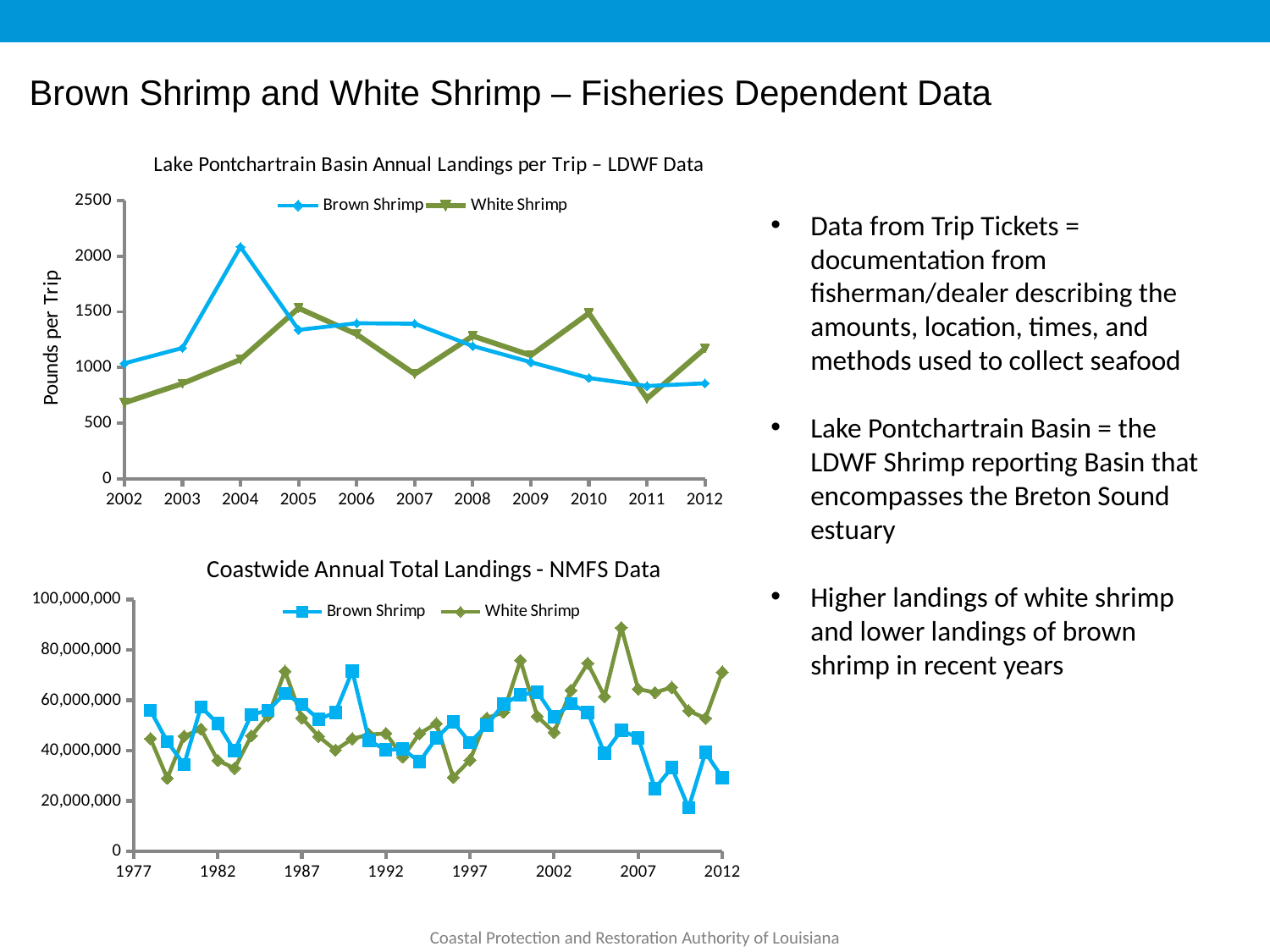
In the top chart (Lake Pontchartrain Basin Annual Landings per Trip), is the White Shrimp value for 2002 greater or less than 1000? less In the bottom chart (Coastwide Annual Total Landings - NMFS Data), what kind of chart is shown? Line chart In the bottom chart (Coastwide Annual Total Landings - NMFS Data), in which year is the White Shrimp value highest? 2006 In the top chart (Lake Pontchartrain Basin Annual Landings per Trip), in which year is the Brown Shrimp value highest? 2004 In the top chart (Lake Pontchartrain Basin Annual Landings per Trip), how many series does the legend list? 2 In the top chart (Lake Pontchartrain Basin Annual Landings per Trip), is the Brown Shrimp value for 2004 greater or less than 2000? greater In the top chart (Lake Pontchartrain Basin Annual Landings per Trip), how many years are plotted on the x axis? 11 In the top chart (Lake Pontchartrain Basin Annual Landings per Trip), which series has the higher value in 2010, Brown Shrimp or White Shrimp? White Shrimp In the bottom chart (Coastwide Annual Total Landings - NMFS Data), is the White Shrimp value for 2006 greater or less than 80,000,000? greater In the top chart (Lake Pontchartrain Basin Annual Landings per Trip), what kind of chart is shown? Line chart In the top chart (Lake Pontchartrain Basin Annual Landings per Trip), in which year is the White Shrimp value highest? 2005 In the bottom chart (Coastwide Annual Total Landings - NMFS Data), in which year is the Brown Shrimp value lowest? 2010